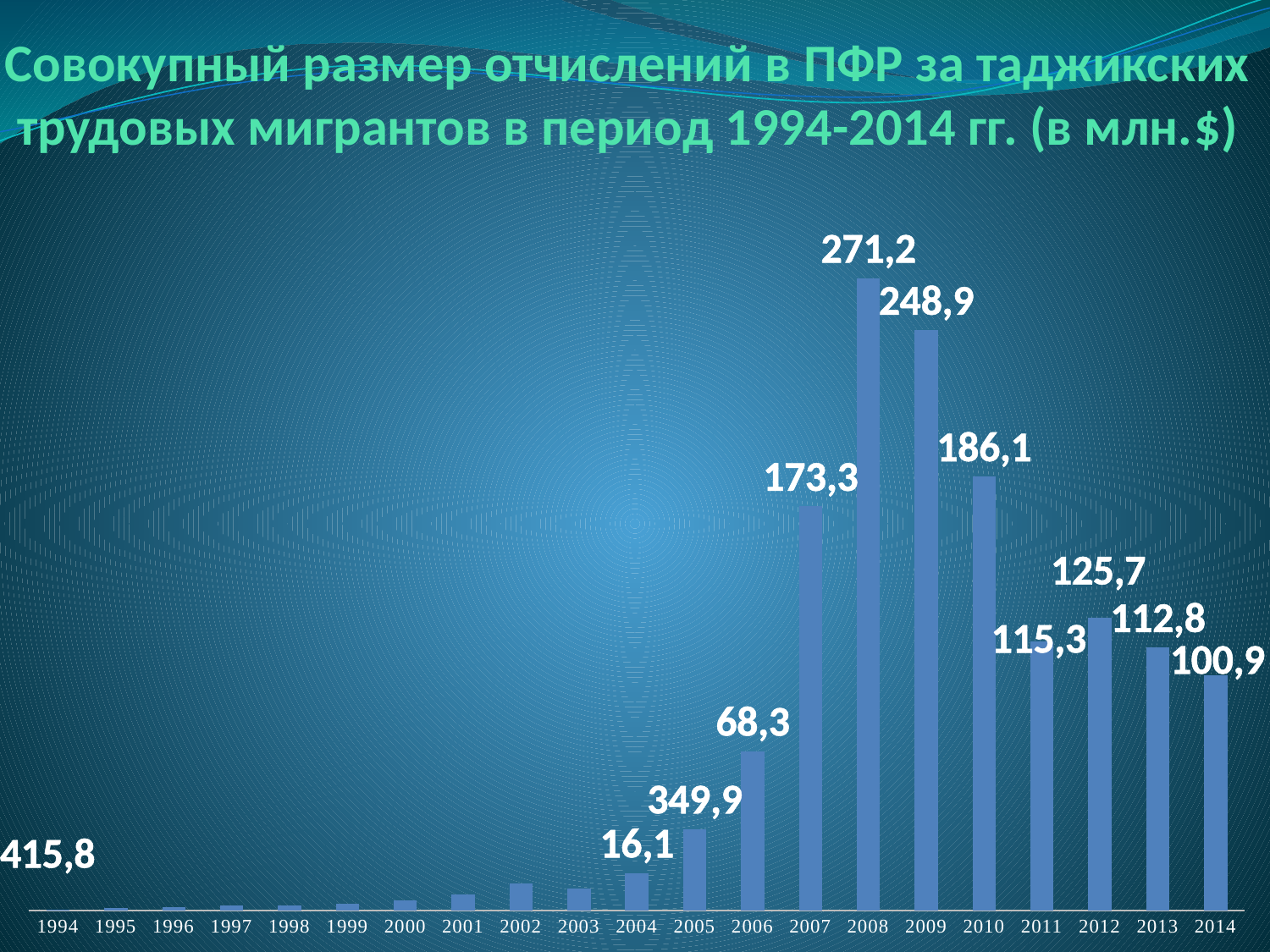
What is the difference between the values for 2012 and 2013? 12,9 Do the values rise or fall from 2008 to 2014? fall What is the difference between the values for 2008 and 2009? 22,3 What is the value for 2009? 248,9 How many years are shown on the x axis? 21 Which is larger, the value for 2011 or the value for 2012? 2012 What is the value for 2010? 186,1 What is the value for 2014? 100,9 What kind of chart is shown on the slide? bar chart What is the value for 2006? 68,3 Which year has the highest value? 2008 What is the value for 2008? 271,2